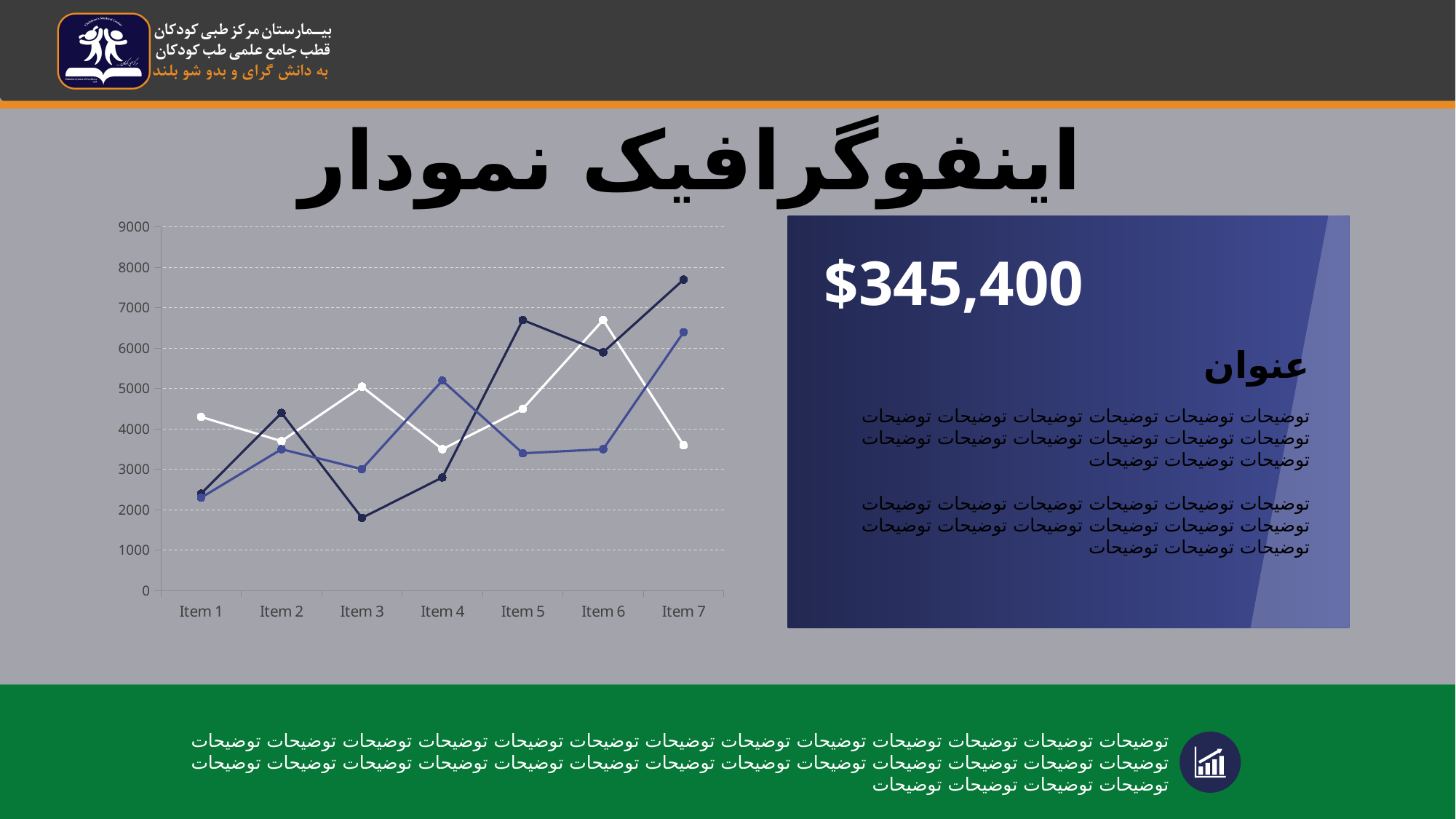
At which item does the dark navy line reach its highest value? Item 7 What is the highest value shown on the chart's y axis? 9000 How many lines are plotted on the chart? 3 At which item does the dark navy line reach its lowest value? Item 3 Is the value of the medium blue line at Item 5 greater or less than 4000? less At Item 3, which line has the higher value, the white line or the dark navy line? the white line Is the value of the dark navy line at Item 7 greater or less than 7000? greater At which item does the medium blue line reach its lowest value? Item 1 What kind of chart is shown on the slide? line chart How many categories are shown on the x axis of the chart? 7 Is the value of the dark navy line at Item 3 greater or less than 2000? less At which item does the white line reach its highest value? Item 6